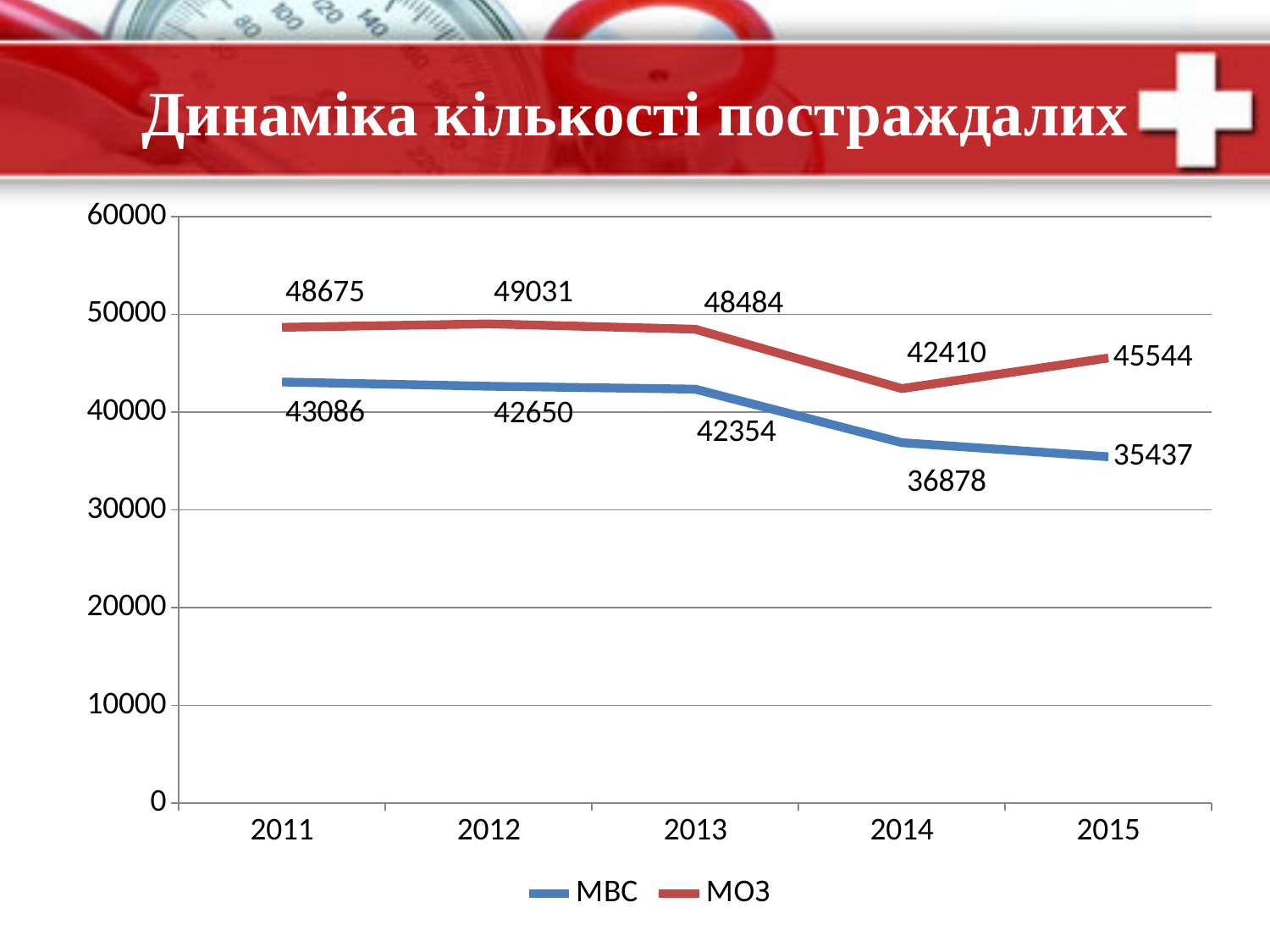
What is the value for МВС in 2015? 35437 In which year is the МОЗ series highest? 2012 In which year is the МВС series lowest? 2015 What is the value for МОЗ in 2012? 49031 What is the difference between the МВС values for 2013 and 2014? 5476 What kind of chart is shown on the slide? line chart How many series does the legend list? 2 How many years are shown on the x axis? 5 Which is larger in 2015, the МВС value or the МОЗ value? МОЗ What is the difference between МОЗ and МВС in 2011? 5589 What is the value for МВС in 2014? 36878 Does the МВС series rise or fall from 2011 to 2015? fall